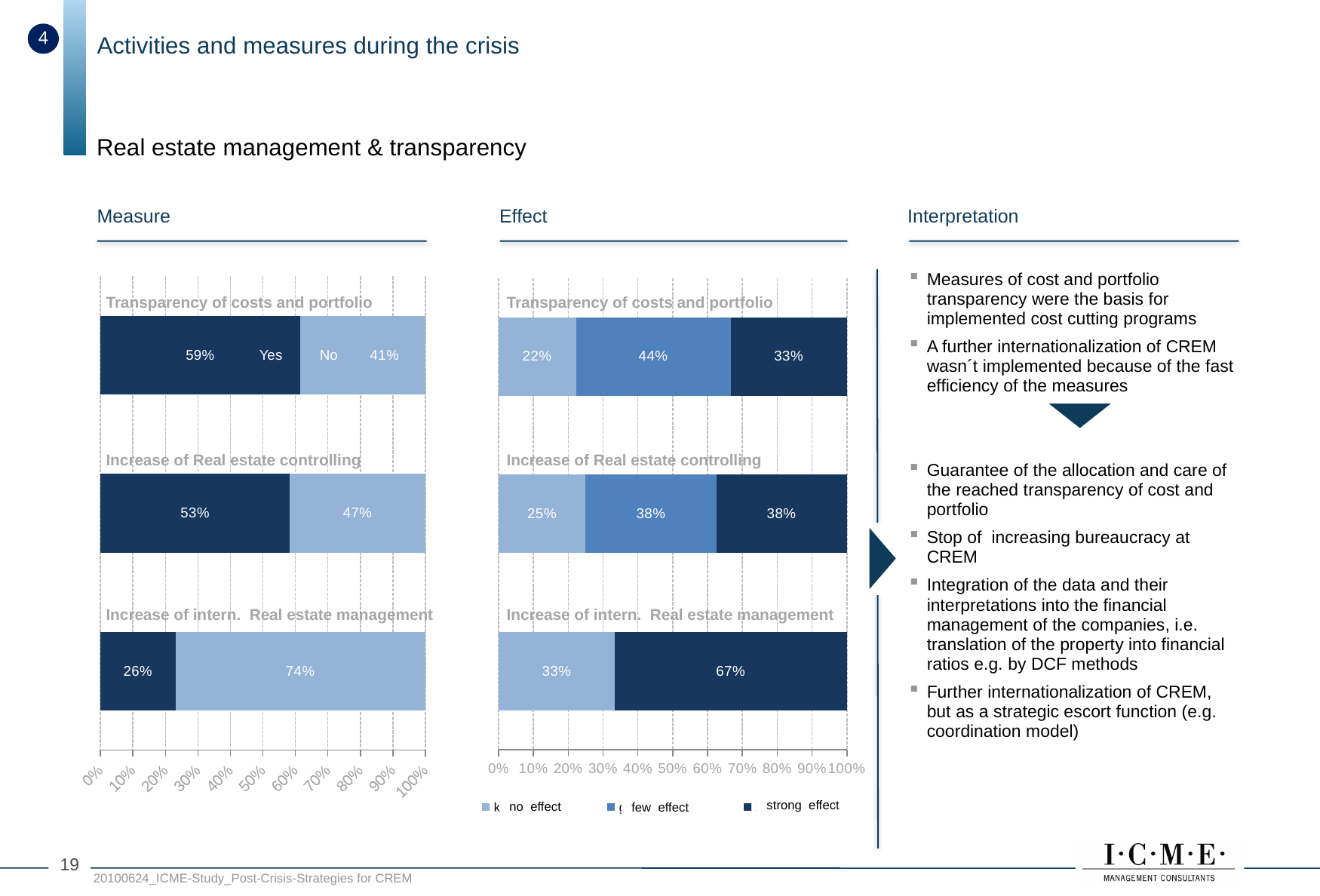
In the Effect chart, what is the strong effect share for Increase of intern. Real estate management? 67% In the Measure chart, what is the No share for Increase of intern. Real estate management? 74% In the Effect chart, which measure has the highest strong effect share? Increase of intern. Real estate management How many series does the legend of the Effect chart list? 3 How many measures are shown in the Measure chart? 3 In the Measure chart, which measure has the lowest Yes share? Increase of intern. Real estate management In the Measure chart, which measure has the highest Yes share? Transparency of costs and portfolio In the Effect chart, is the no effect share larger for Increase of Real estate controlling or for Transparency of costs and portfolio? Increase of Real estate controlling In the Measure chart, what is the difference between the Yes and No shares for Increase of Real estate controlling? 6% In the Measure chart, what percentage answered Yes for Transparency of costs and portfolio? 59% In the Effect chart, what is the few effect share for Transparency of costs and portfolio? 44% What type of chart is the Effect chart? Stacked bar chart